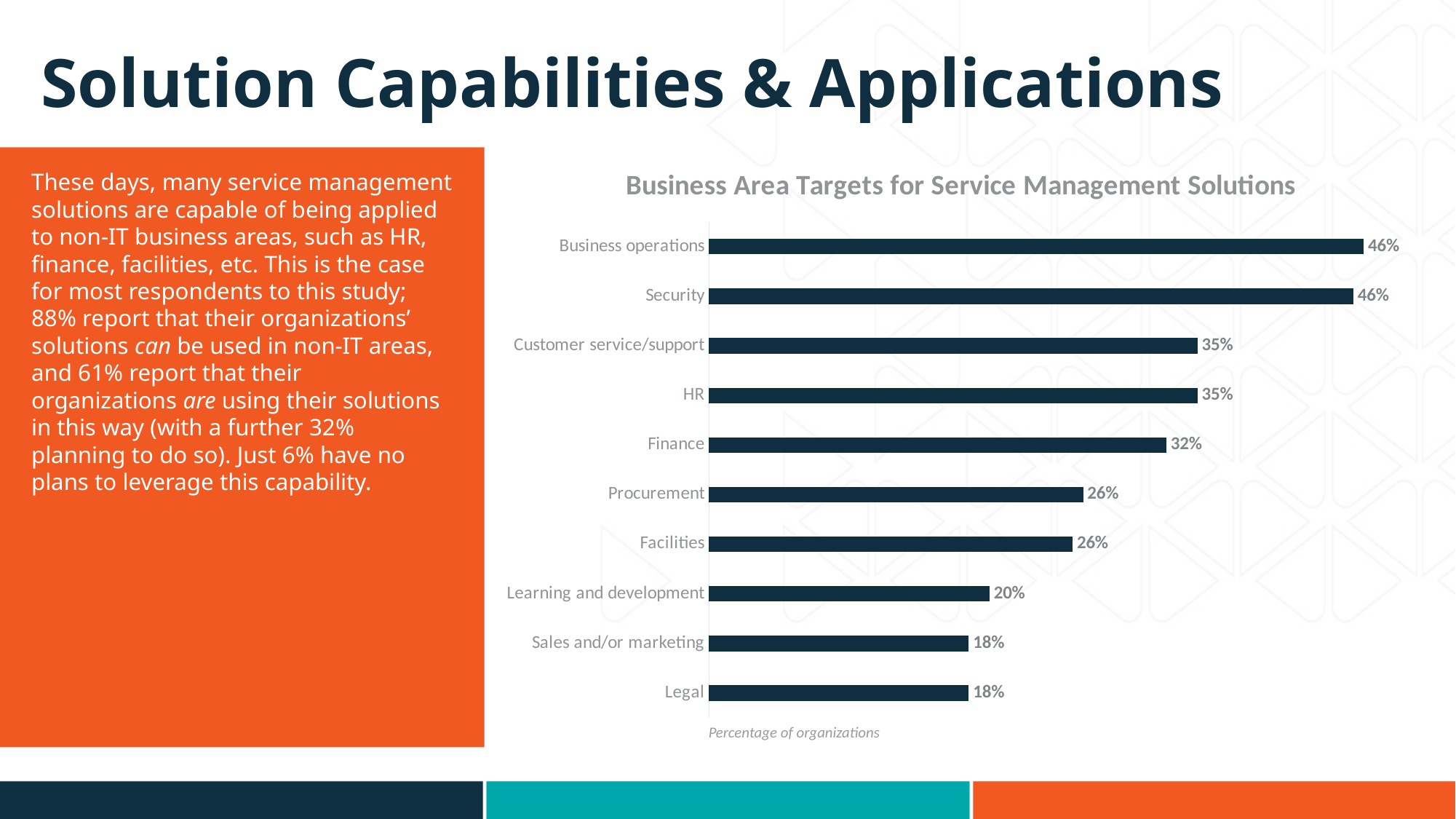
What type of chart is shown on the slide? Bar chart What is the lowest percentage shown in the chart? 18% How many business areas are shown in the chart? 10 What is the value shown for Learning and development? 20% What percentage of organizations target Finance with their service management solutions? 32% What is the difference between the values for Business operations and Legal? 28% What is the title of the chart? Business Area Targets for Service Management Solutions Which has a larger value, Finance or Procurement? Finance What is the value shown for Procurement? 26% What is the difference between the values for HR and Facilities? 9% What is the highest percentage shown in the chart? 46% What is the value shown for Customer service/support? 35%